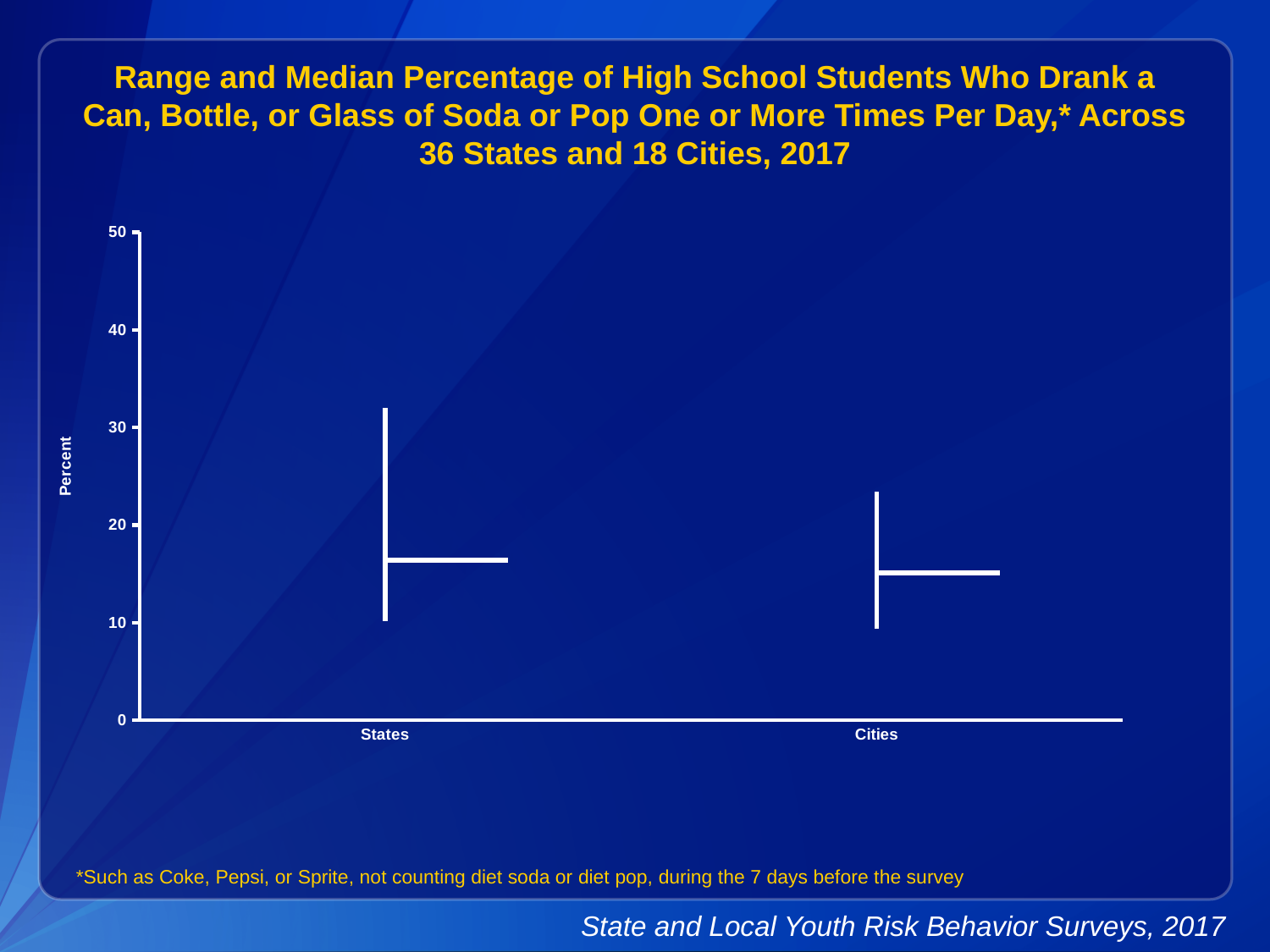
What are the two categories shown on the x axis? States and Cities Is the median value for States greater or less than 10? greater What is the label on the y axis of the chart? Percent How many categories are shown on the x axis of the chart? 2 What is the highest value shown on the y axis of the chart? 50 Is the top of the range for Cities greater or less than 30? less Is the median value for Cities greater or less than 20? less Which category has the wider range of values, States or Cities? States Which category has the higher top of its range, States or Cities? States